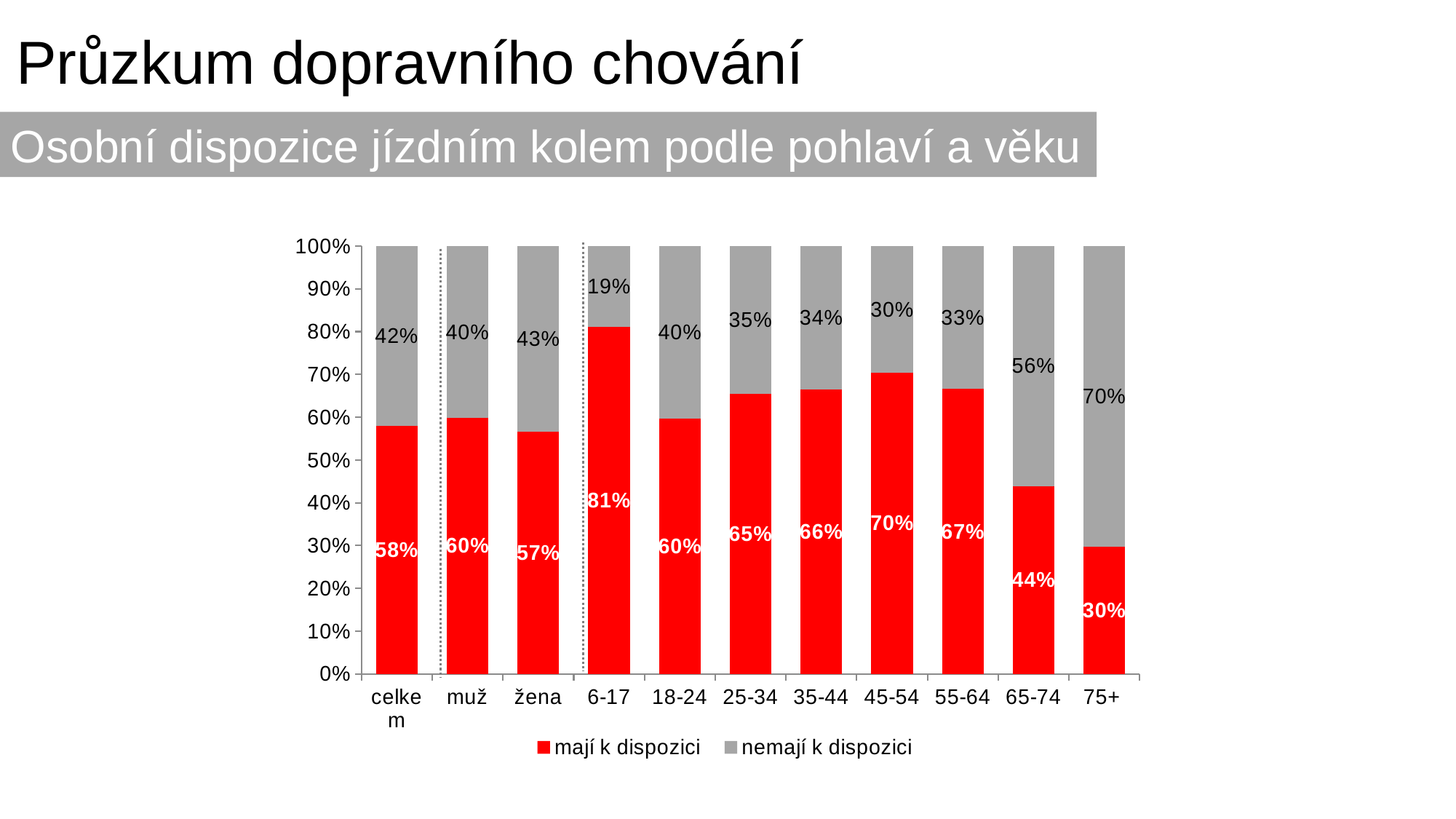
How many series does the legend list? 2 What is the 'mají k dispozici' value for 'žena'? 57% Which colour represents 'nemají k dispozici' in the chart? Grey What percentage of the 6-17 age group has a bicycle available (mají k dispozici)? 81% Which category has the highest 'mají k dispozici' value? 6-17 What is the total of the stacked bar for the 45-54 age group? 100% How many categories are shown on the x axis? 11 What kind of chart is shown on the slide? Stacked bar chart Which has a larger 'nemají k dispozici' value, 65-74 or 55-64? 65-74 What is the value of 'nemají k dispozici' for the 75+ age group? 70% Which category has the lowest 'mají k dispozici' value? 75+ What is the difference between the 'mají k dispozici' values for 'muž' and 'žena'? 3%